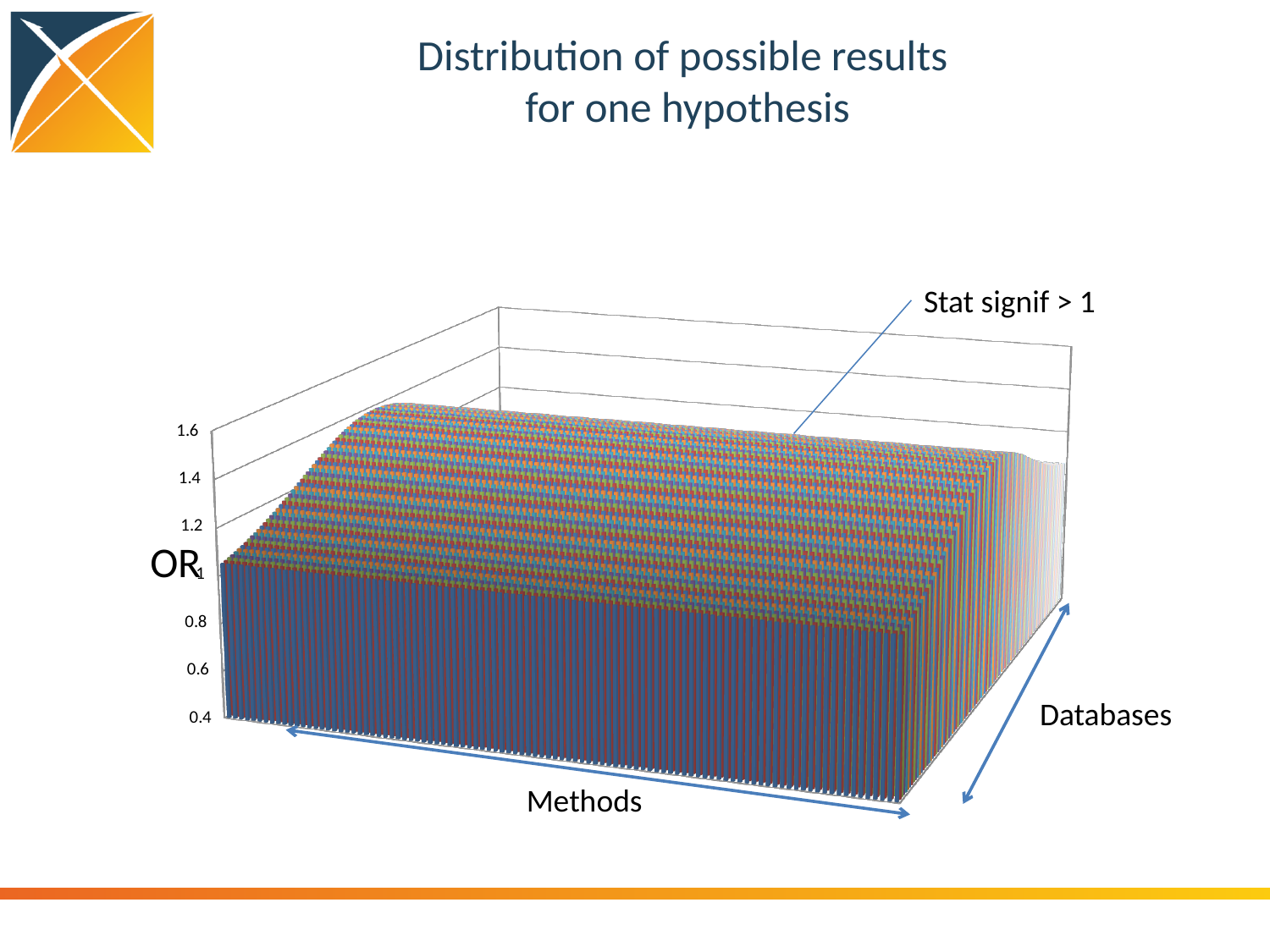
What is the highest tick value shown on the vertical axis? 1.6 What kind of chart is shown on the slide? bar chart What is the lowest tick value shown on the vertical axis? 0.4 Do the bar heights rise or fall moving from the left end of the Methods axis toward the middle of the chart? rise What label is shown on the vertical axis of the chart? OR What is the title of the chart? Distribution of possible results for one hypothesis Are the bars at the left end of the Methods axis lower or higher than the bars in the middle of the chart? lower